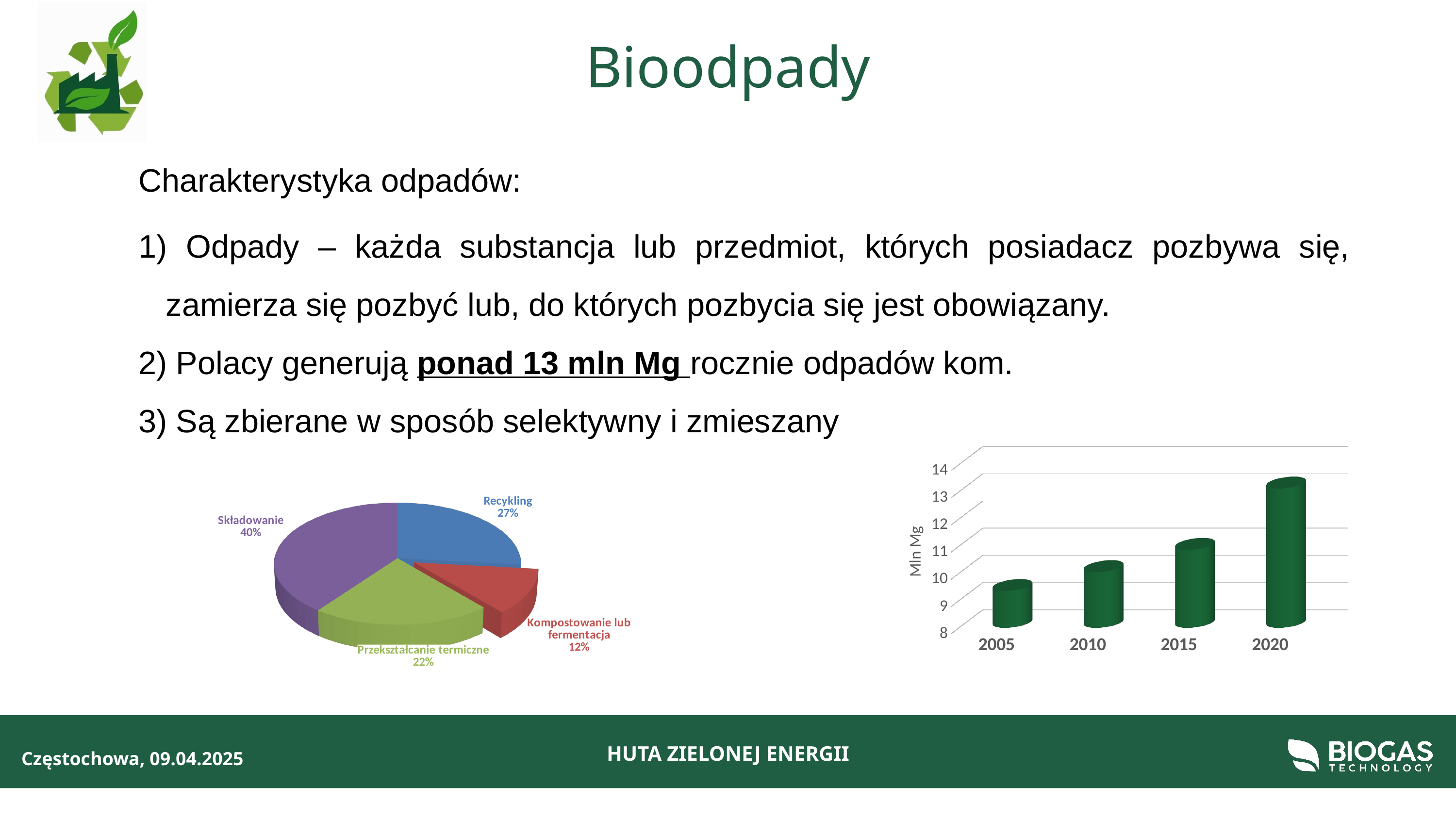
In the pie chart on the left, what share does Kompostowanie lub fermentacja have? 12% In the bar chart on the right, is the value for 2005 greater or less than 10? less In the bar chart on the right, do the values rise or fall from 2005 to 2020? Rise In the pie chart on the left, which category has the largest share? Składowanie In the pie chart on the left, what is the difference in percentage points between Składowanie and Przekształcanie termiczne? 18 In the pie chart on the left, what share does Recykling have? 27% In the pie chart on the left, what share does Składowanie have? 40% In the bar chart on the right, is the value for 2020 greater or less than 12? greater In the pie chart on the left, which category has the smallest share? Kompostowanie lub fermentacja How many categories does the pie chart on the left show? 4 In the pie chart on the left, which is larger: Recykling or Przekształcanie termiczne? Recykling What kind of chart is the chart on the right of the slide? Bar chart